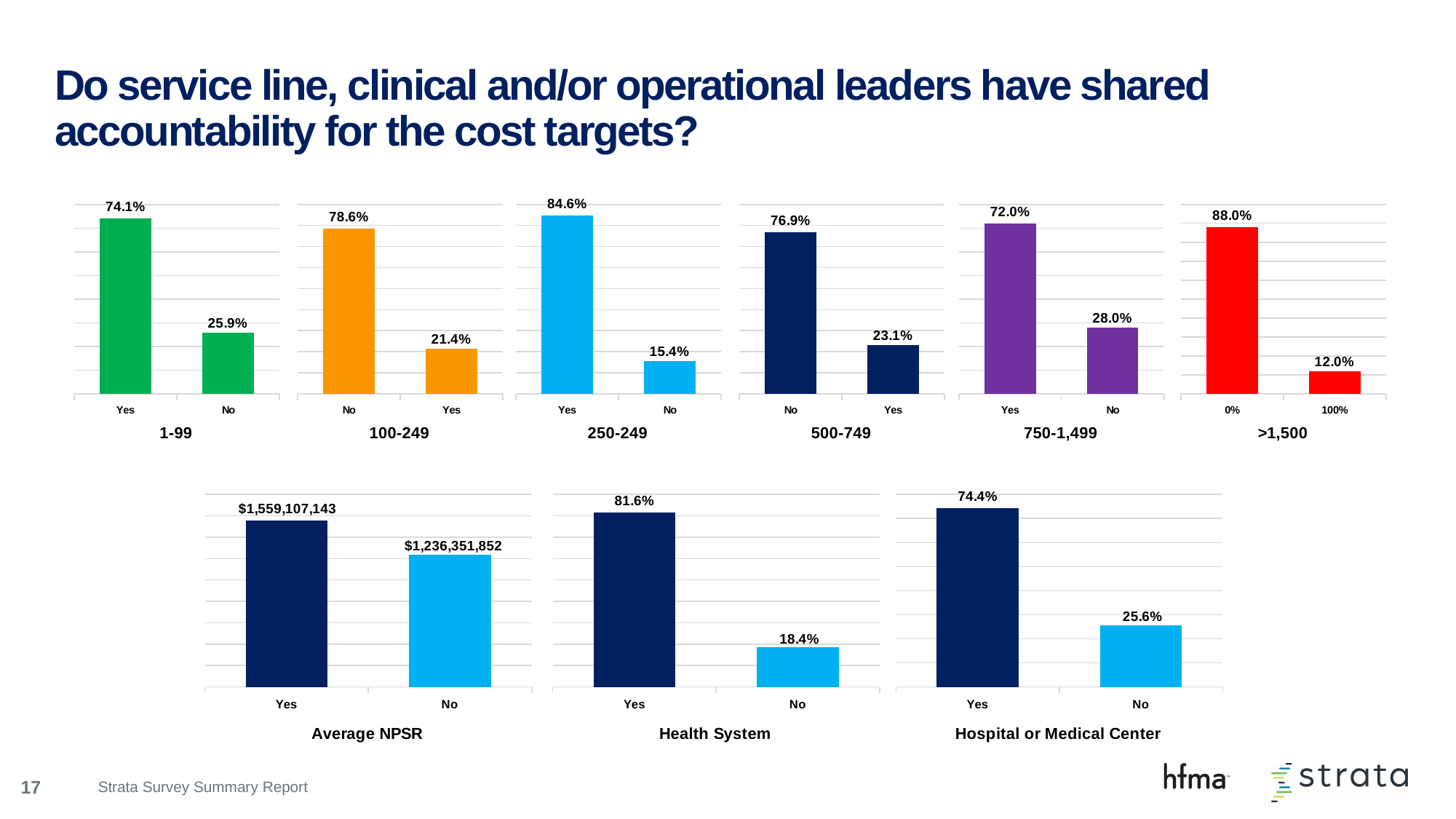
In the chart titled "1-99", what is the value for Yes? 74.1% In the chart titled "Average NPSR", which is larger, Yes or No? Yes How many bars are in the chart titled "Health System"? 2 In the chart titled "500-749", what is the difference between the No and Yes values? 53.8% In the chart titled "Health System", what is the value for No? 18.4% In the chart titled "Average NPSR", what is the value for Yes? $1,559,107,143 In the chart titled "750-1,499", which category has the highest value? Yes In the chart titled ">1,500", what is the value for the bar labelled 100%? 12.0% In the chart titled "Hospital or Medical Center", what is the difference between the Yes and No values? 48.8% In the chart titled "250-249", what is the value for No? 15.4% In the chart titled "100-249", what is the value for No? 78.6% What kind of chart is the chart titled "1-99"? Bar chart